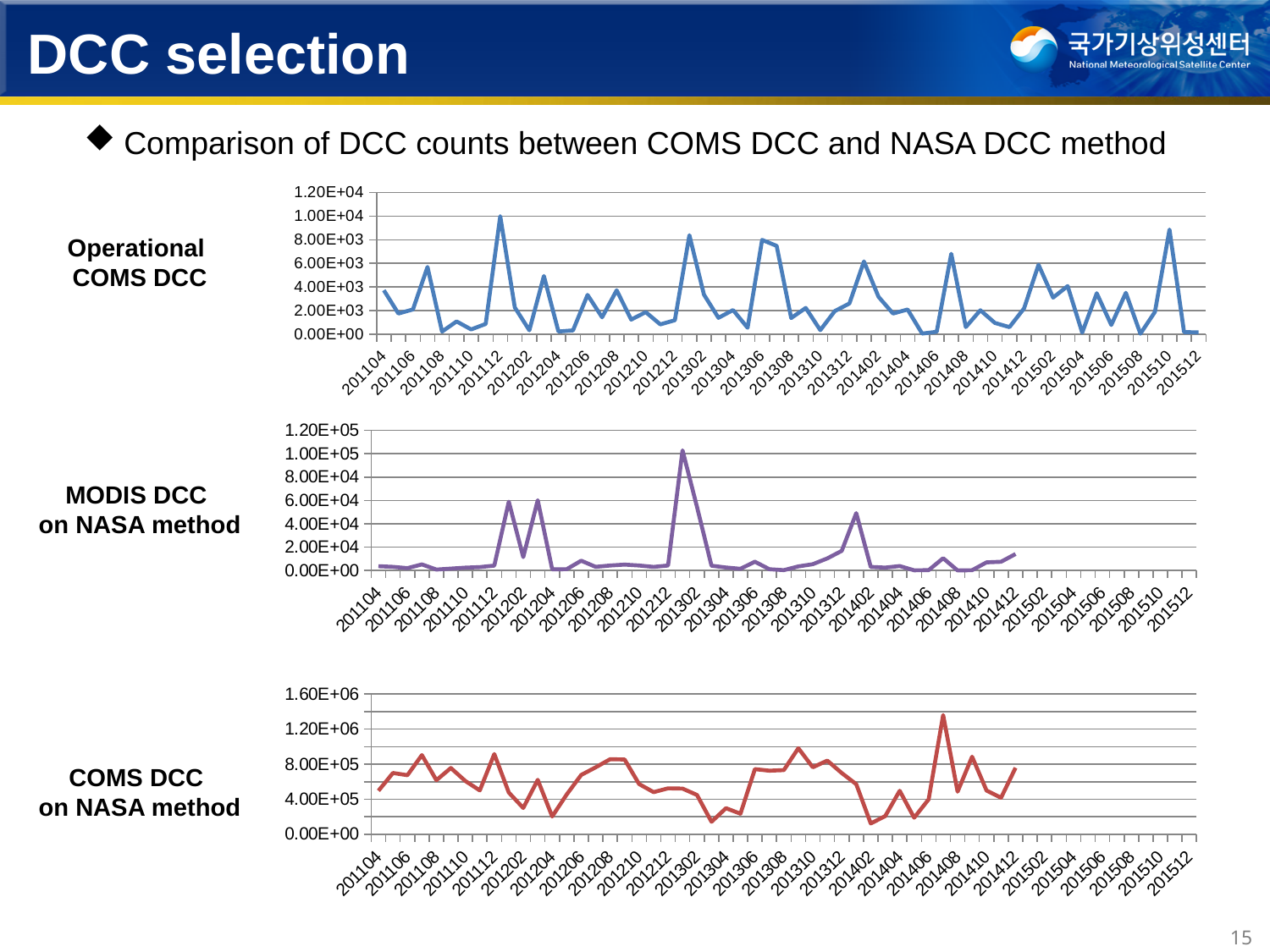
In the 'COMS DCC on NASA method' chart, is the value for 201408 greater or less than 1.20E+06? less In the 'Operational COMS DCC' chart, which is larger, the value for 201112 or the value for 201302? 201112 In the 'Operational COMS DCC' chart, is the value for 201112 greater or less than 8.00E+03? greater What kind of chart is the top chart labelled 'Operational COMS DCC'? line chart In the 'MODIS DCC on NASA method' chart, is the value for 201202 greater or less than 4.00E+04? less In the 'MODIS DCC on NASA method' chart, which month has the highest DCC count? 201301 In the 'Operational COMS DCC' chart, which month has the highest DCC count? 201112 What colour is the line in the 'COMS DCC on NASA method' chart? red How many charts are shown on the slide? 3 In the 'COMS DCC on NASA method' chart, which month has the highest DCC count? 201407